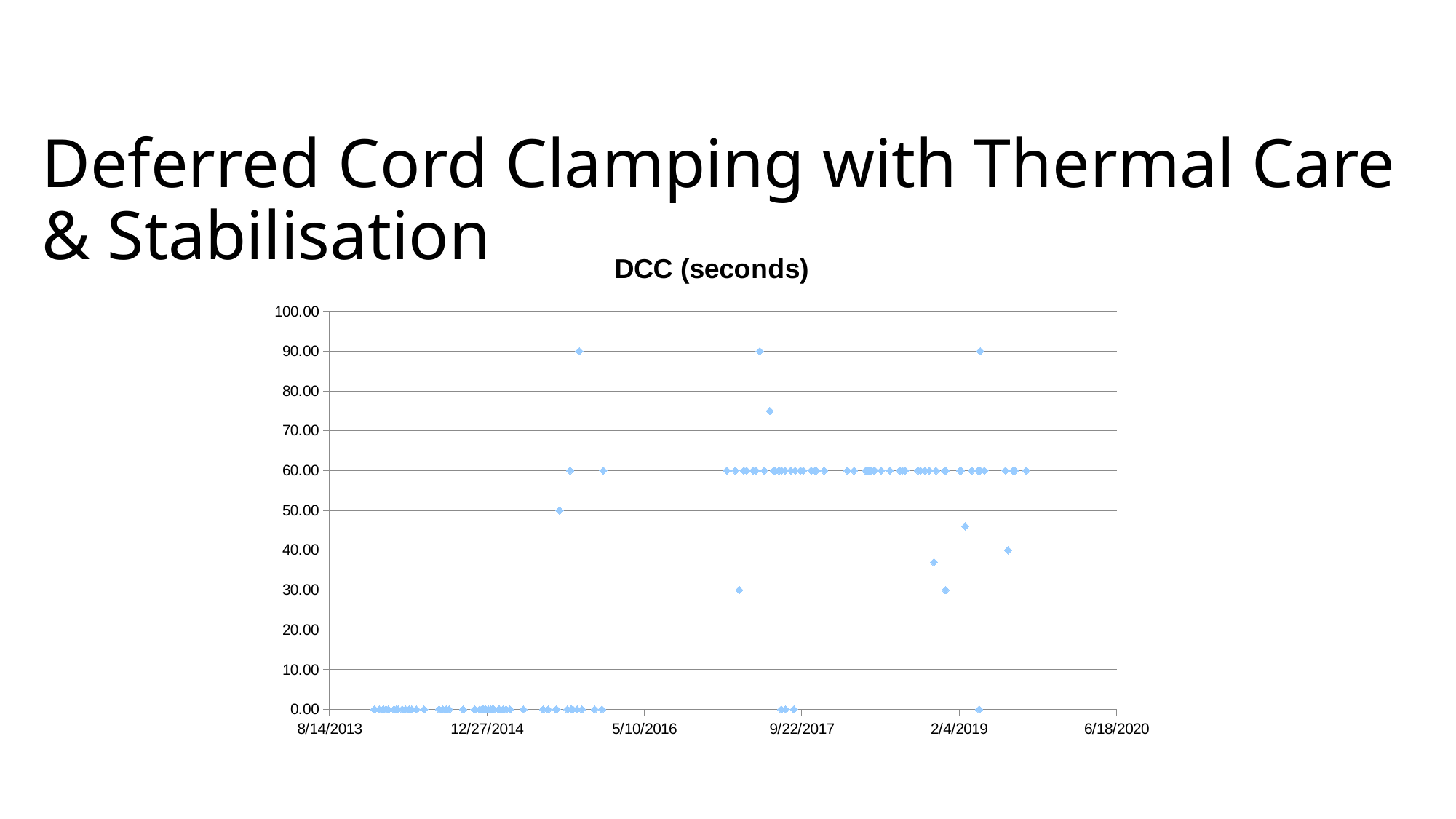
What kind of chart is shown on the slide? scatter chart What is the highest value reached by any point on the chart? 90.00 Is the value of the isolated point just after 2/4/2019 that sits between the 40.00 and 50.00 gridlines greater or less than 40.00? greater What is the lowest value reached by any point on the chart? 0.00 What is the title of the chart? DCC (seconds) What is the last date label on the horizontal axis? 6/18/2020 Is the value of the isolated point just before 2/4/2019 that sits between the 30.00 and 40.00 gridlines greater or less than 40.00? less How many date labels are shown on the horizontal axis? 6 What is the first date label on the horizontal axis? 8/14/2013 What is the maximum value shown on the vertical axis? 100.00 Is the value of the isolated point between 9/22/2017 and the 80.00 gridline greater or less than 70.00? greater Do the plotted values generally rise or fall from the earliest dates to the latest dates? rise